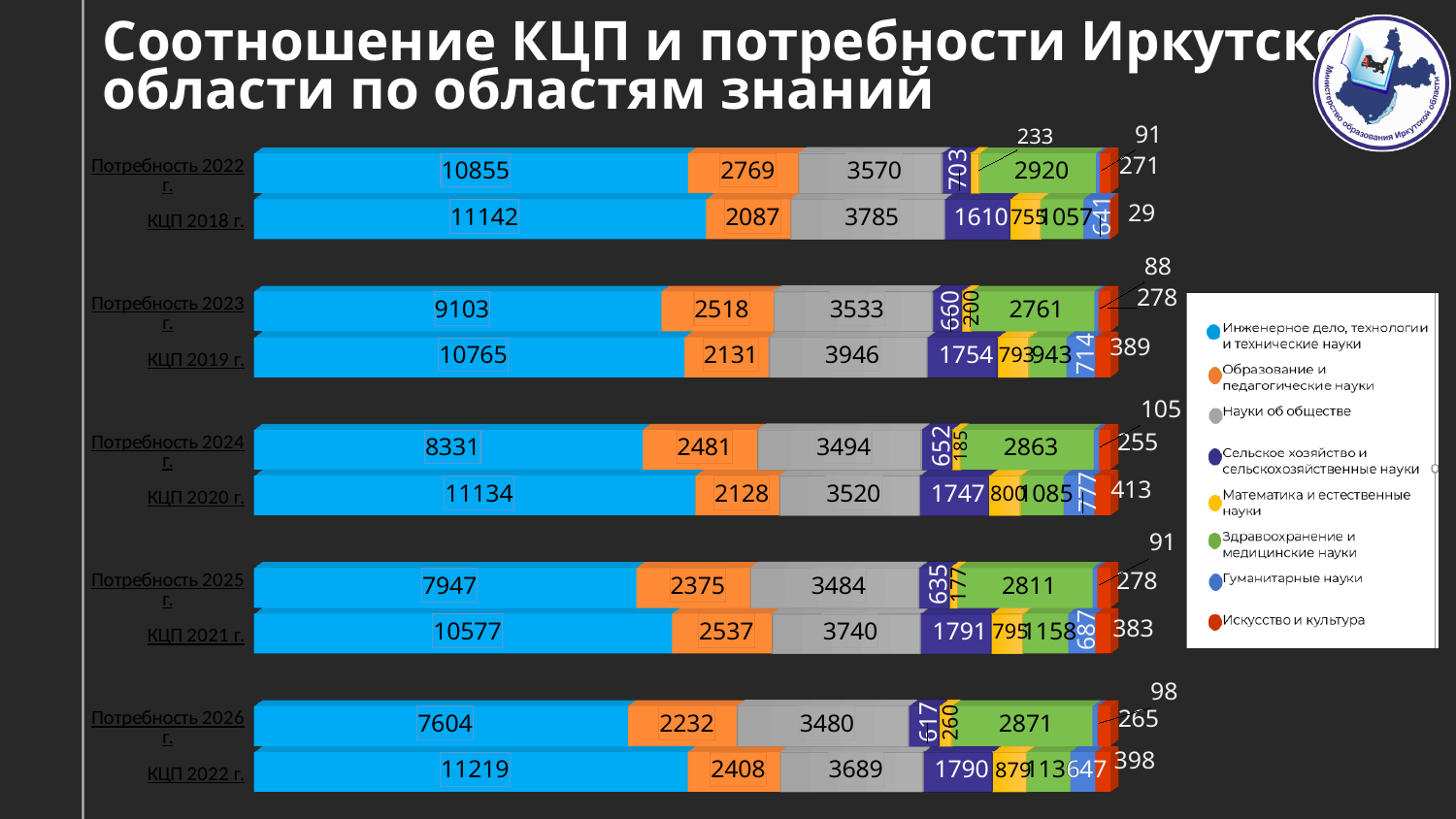
How many series does the legend list? 8 Which bar has the highest value for Инженерное дело, технологии и технические науки? КЦП 2022 г. What is the value for Здравоохранение и медицинские науки in the Потребность 2026 г. bar? 2871 What is the difference between the Науки об обществе values for КЦП 2020 г. and Потребность 2024 г.? 26 What is the value for Науки об обществе in the КЦП 2019 г. bar? 3946 How many bars (categories) are shown in the chart? 10 What is the value for Образование и педагогические науки in the КЦП 2022 г. bar? 2408 Does the Инженерное дело, технологии и технические науки value rise or fall across the Потребность bars from 2022 г. to 2026 г.? fall Which has the larger value for Образование и педагогические науки: Потребность 2022 г. or КЦП 2018 г.? Потребность 2022 г. What is the difference between the Инженерное дело, технологии и технические науки values for КЦП 2018 г. and Потребность 2022 г.? 287 Which bar has the lowest value for Инженерное дело, технологии и технические науки? Потребность 2026 г. What is the value for Инженерное дело, технологии и технические науки in the Потребность 2022 г. bar? 10855